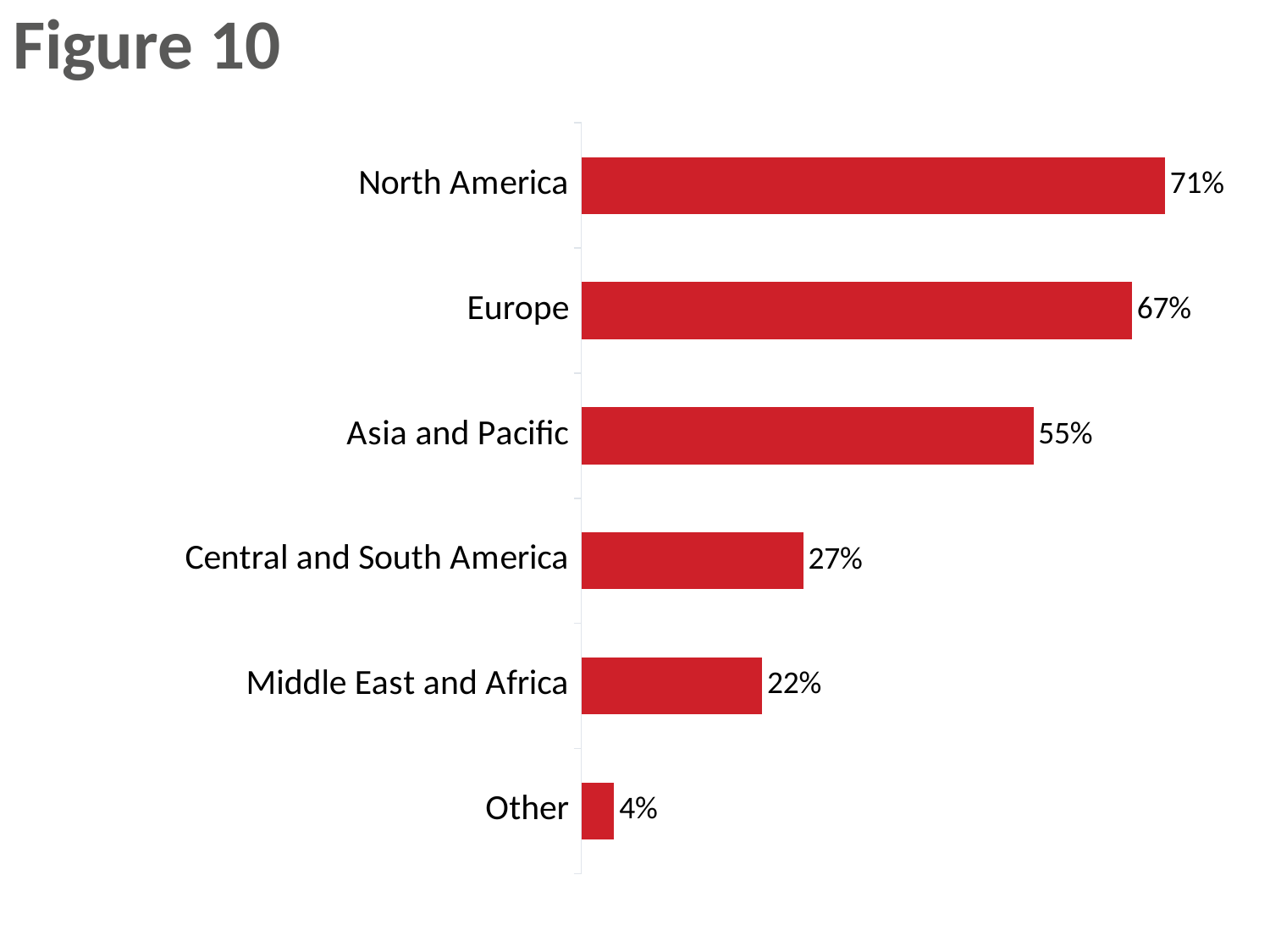
What is the value for Asia and Pacific? 55% Which is larger, the value for Central and South America or the value for Middle East and Africa? Central and South America What is the value for North America? 71% How many categories are shown in the chart? 6 What is the value for Other? 4% What is the difference between the values for North America and Europe? 4% Which category has the highest value? North America What is the difference between the values for Asia and Pacific and Central and South America? 28% What is the title of the slide? Figure 10 What kind of chart is shown on the slide? Bar chart What is the value for Middle East and Africa? 22% Which category has the lowest value? Other